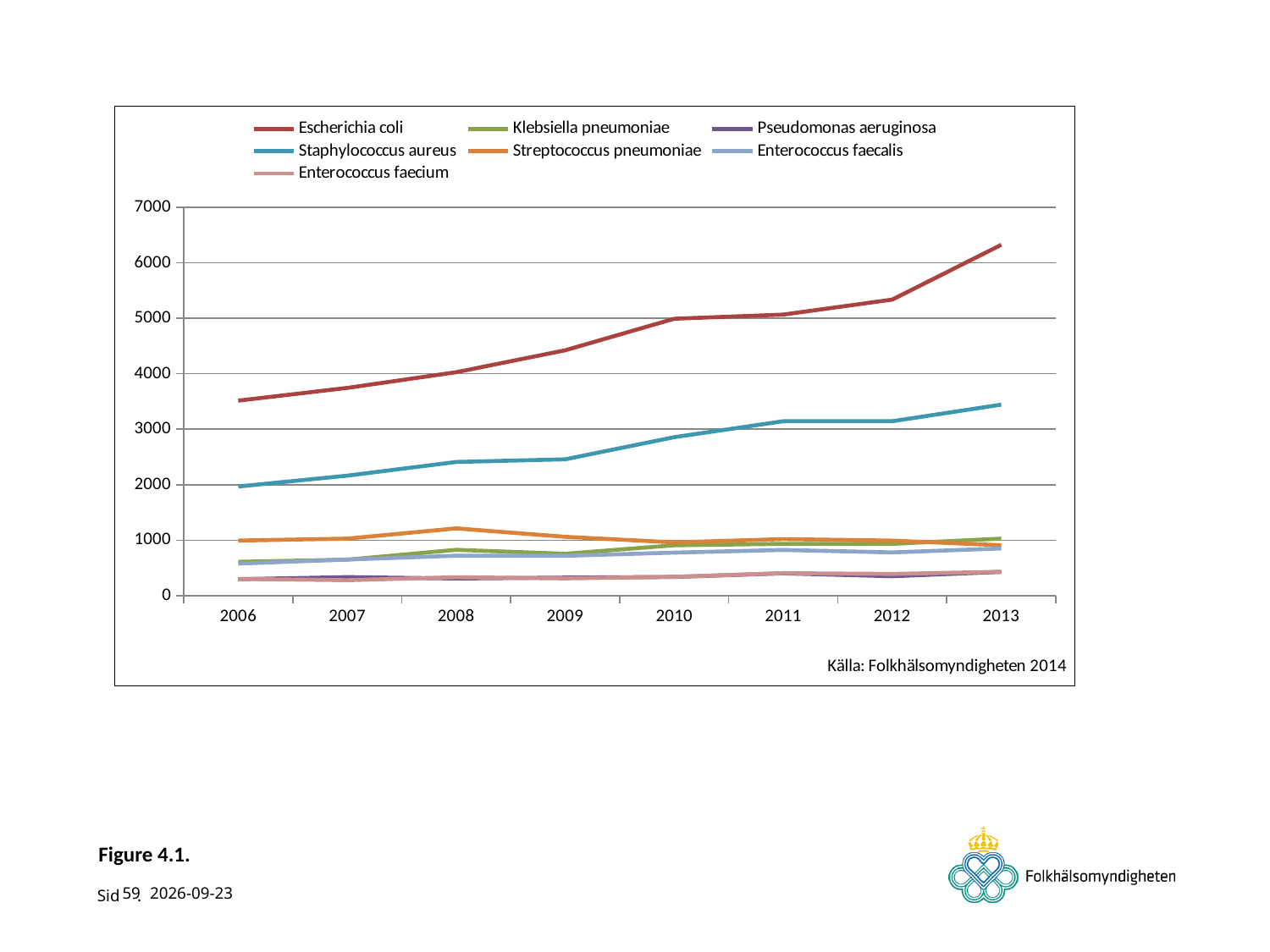
Is the value for Streptococcus pneumoniae in 2008 greater or less than 1000? greater Is the value for Escherichia coli in 2013 greater or less than 6000? greater Which series has the highest value in 2013? Escherichia coli Is the value for Staphylococcus aureus in 2013 greater or less than 3000? greater What source is cited below the chart? Källa: Folkhälsomyndigheten 2014 How many years are shown along the x axis? 8 In 2008, which is larger: Streptococcus pneumoniae or Klebsiella pneumoniae? Streptococcus pneumoniae In 2010, which is larger: Escherichia coli or Staphylococcus aureus? Escherichia coli Does the Escherichia coli line rise or fall from 2006 to 2013? rise How many series does the legend list? 7 What kind of chart is shown on the slide? line chart